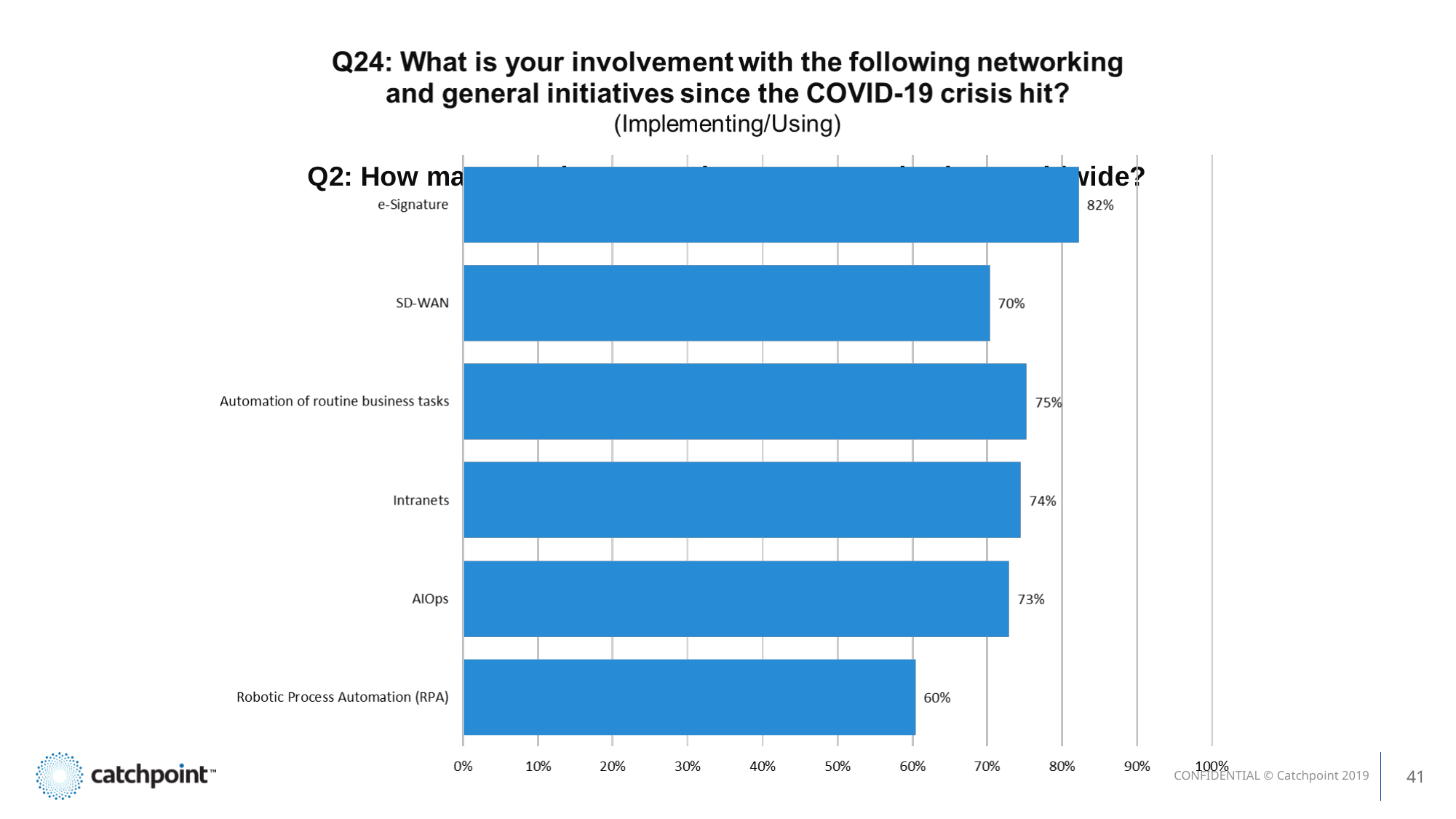
Which is larger, the value for AIOps or the value for SD-WAN? AIOps What is the value for Intranets? 74% What is the difference between the values for Automation of routine business tasks and SD-WAN? 5% Which category has the lowest value? Robotic Process Automation (RPA) How many categories are shown in the chart? 6 What is the difference between the values for e-Signature and Robotic Process Automation (RPA)? 22% Which category has the highest value? e-Signature What is the value for Robotic Process Automation (RPA)? 60% What is the value for e-Signature? 82% Is the value for Intranets greater or less than 50%? greater What kind of chart is shown on the slide? Bar chart What is the value for SD-WAN? 70%